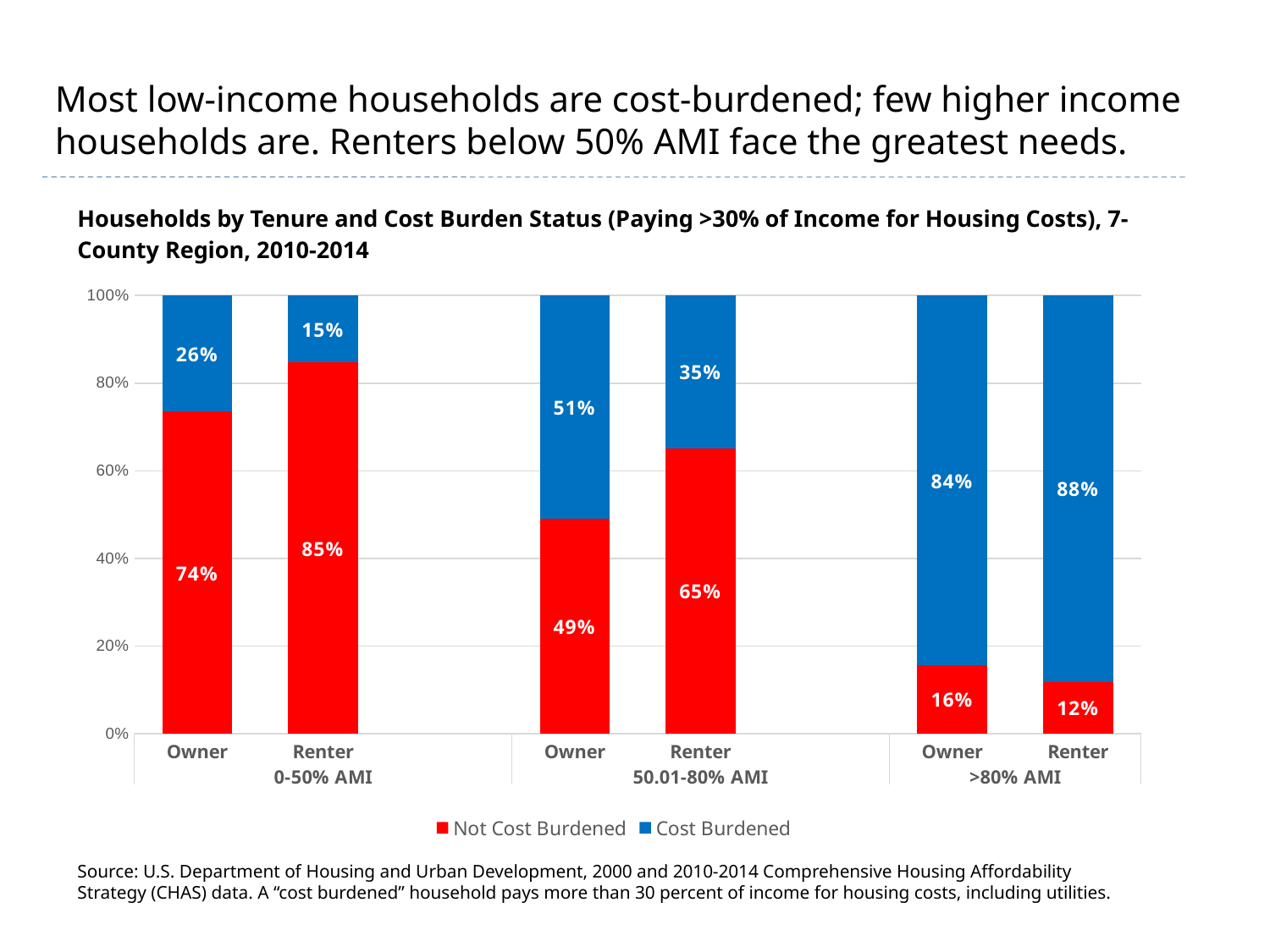
How many series does the legend list? 2 What is the Cost Burdened share for Renter households in the >80% AMI group? 88% What is the Cost Burdened share for Owner households in the 50.01-80% AMI group? 51% Which bar has the highest Cost Burdened share? Renter, >80% AMI In the 50.01-80% AMI group, what is the difference between the Cost Burdened share for Owners and for Renters? 16 percentage points What is the Not Cost Burdened share for Owner households in the 0-50% AMI group? 74% Which bar has the lowest Not Cost Burdened share? Renter, >80% AMI How many bars are plotted in the chart? 6 What do the two segments of the Owner bar in the 0-50% AMI group add up to? 100% What kind of chart is shown on the slide? Stacked bar chart What colour represents the Cost Burdened series in the chart? Blue In the 0-50% AMI group, which has the larger Not Cost Burdened share, Owner or Renter? Renter